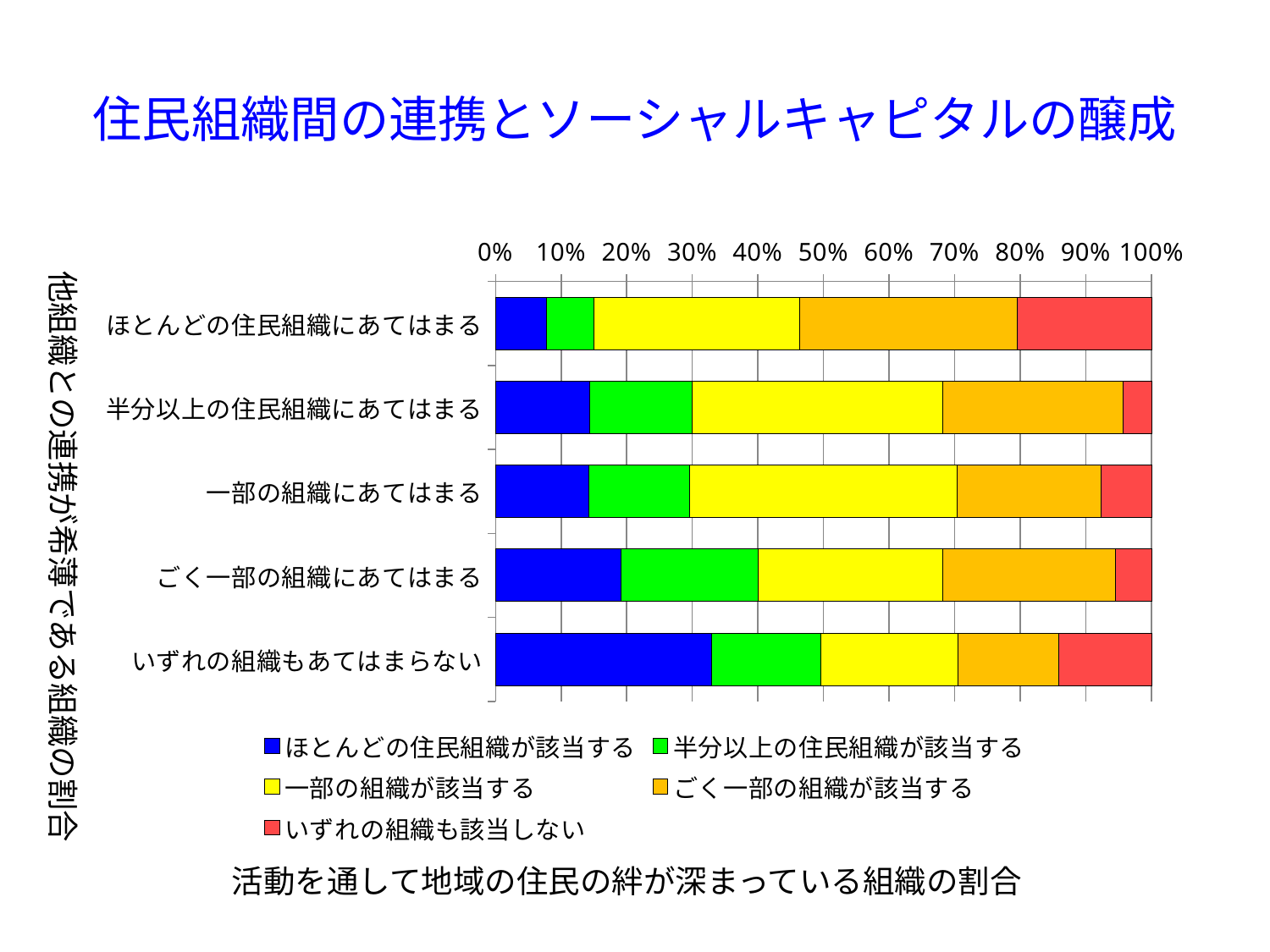
What colour represents 「いずれの組織も該当しない」 in the legend? red Which category has the largest 「ほとんどの住民組織が該当する」 (blue) segment? いずれの組織もあてはまらない Which category has the largest 「いずれの組織も該当しない」 (red) segment? ほとんどの住民組織にあてはまる Is the 「いずれの組織も該当しない」 segment for 「ほとんどの住民組織にあてはまる」 greater or less than 10%? greater Which has the larger 「ほとんどの住民組織が該当する」 (blue) segment: 「ごく一部の組織にあてはまる」 or 「ほとんどの住民組織にあてはまる」? ごく一部の組織にあてはまる What kind of chart is shown on the slide? stacked bar chart Is the 「ほとんどの住民組織が該当する」 segment for 「いずれの組織もあてはまらない」 greater or less than 30%? greater Is the 「ほとんどの住民組織が該当する」 segment for 「ほとんどの住民組織にあてはまる」 greater or less than 10%? less What is the maximum value shown on the horizontal axis? 100% How many categories are plotted on the vertical axis of the chart? 5 Which category has the smallest 「ほとんどの住民組織が該当する」 (blue) segment? ほとんどの住民組織にあてはまる How many series does the chart's legend list? 5